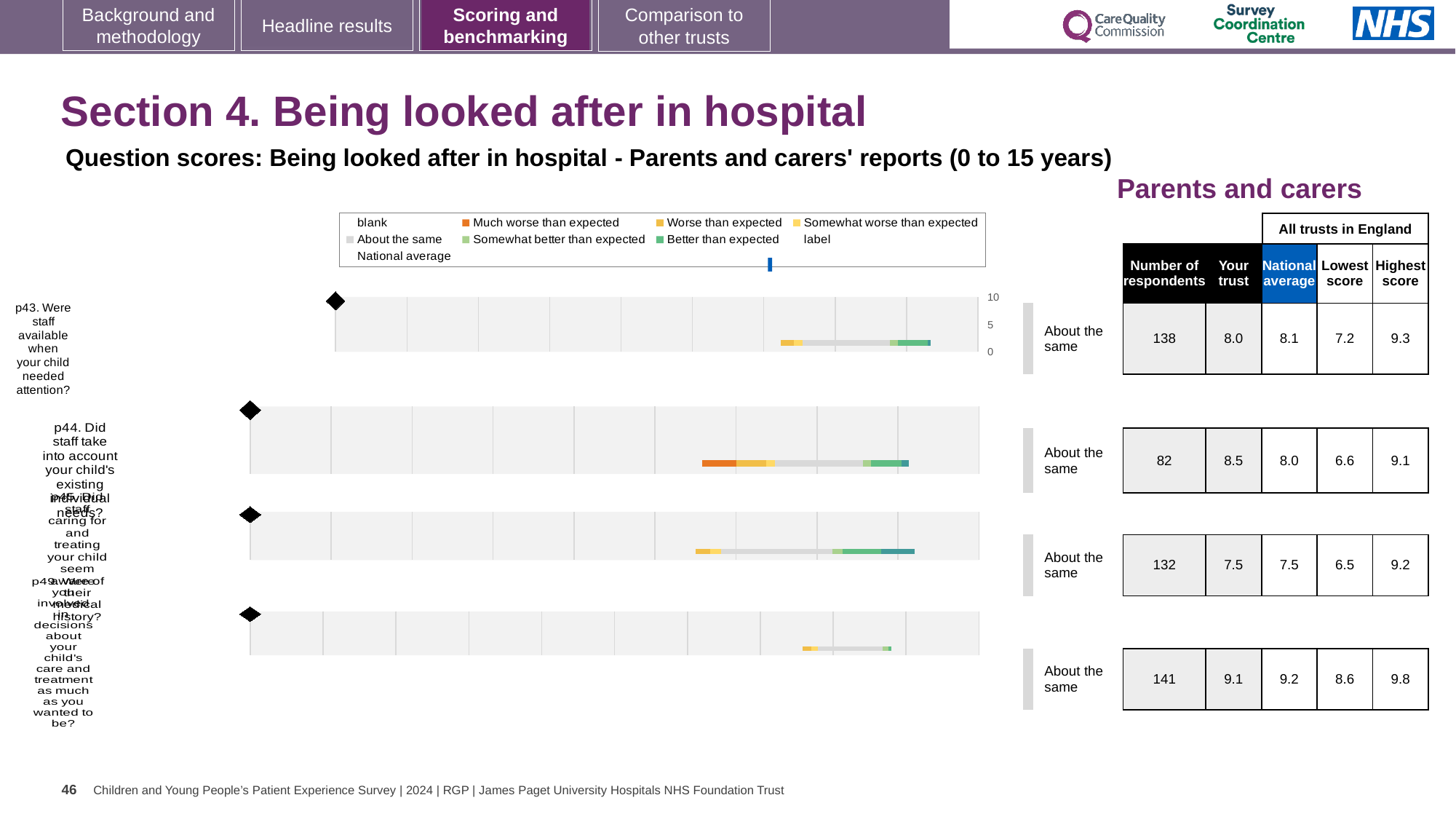
How many respondents answered p49 (Were you involved in decisions about your child's care and treatment as much as you wanted to be?)? 141 What kind of chart is used to show the question scores on this slide? bar chart For p43, which is larger: the 'Your trust' score or the national average? National average What is the national average score for p44 (Did staff take into account your child's existing individual needs?)? 8.0 What is the lowest score among all trusts in England for p44? 6.6 What benchmark category is shown next to the chart for p43? About the same What is the 'Your trust' score for p43 (Were staff available when your child needed attention?)? 8.0 What is the highest score among all trusts in England for p45? 9.2 Which question has the lowest 'Your trust' score on this slide? p45 How many survey questions (p43, p44, p45, p49) have a chart on this slide? 4 For p44, what is the difference between the 'Your trust' score and the national average? 0.5 Which question has the highest 'Your trust' score on this slide? p49